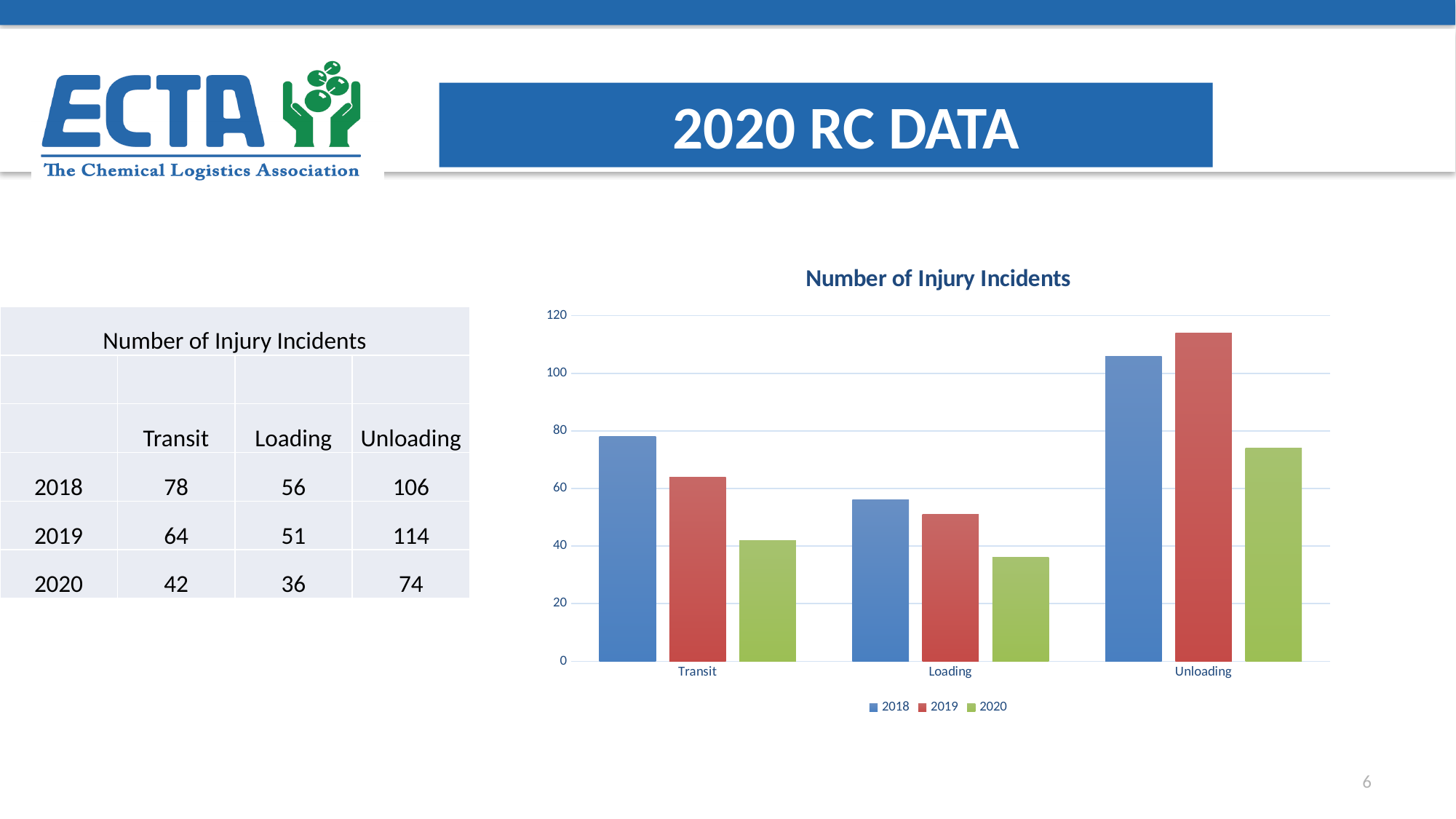
Do the Loading values rise or fall from 2018 to 2020? fall Which category has the highest number of injury incidents in 2018? Unloading Which category has the lowest number of injury incidents in 2020? Loading Which is larger, the Transit value for 2018 or the Loading value for 2018? Transit What is the title of the chart? Number of Injury Incidents What is the number of injury incidents for Transit in 2020? 42 What is the difference between the Unloading values for 2019 and 2020? 40 What is the number of injury incidents for Unloading in 2019? 114 How many series does the chart legend list? 3 Is the value for Unloading in 2018 greater or less than 100? greater How many categories are shown on the x axis of the chart? 3 What type of chart is shown on the slide? bar chart